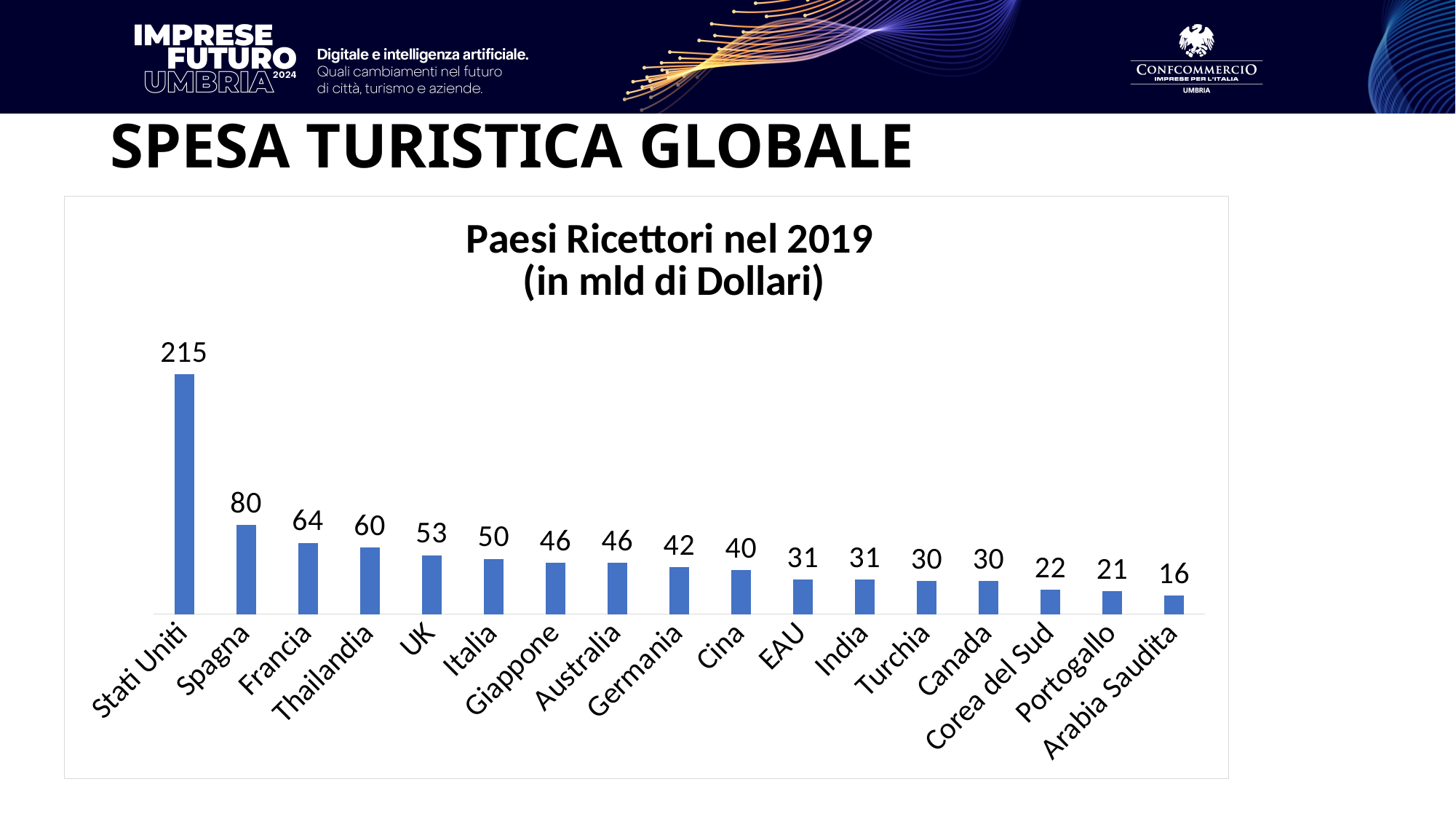
What is the difference between the values for Francia and Italia? 14 How many countries are shown in the chart? 17 What is the value for Corea del Sud? 22 Which country has the lowest value? Arabia Saudita What is the value for Germania? 42 What kind of chart is shown on the slide? Bar chart What is the value for Thailandia? 60 Which country has the highest value? Stati Uniti Which has a larger value, Giappone or Cina? Giappone What is the value for Stati Uniti? 215 What is the title of the chart? Paesi Ricettori nel 2019 (in mld di Dollari) What is the difference between the values for Stati Uniti and Spagna? 135